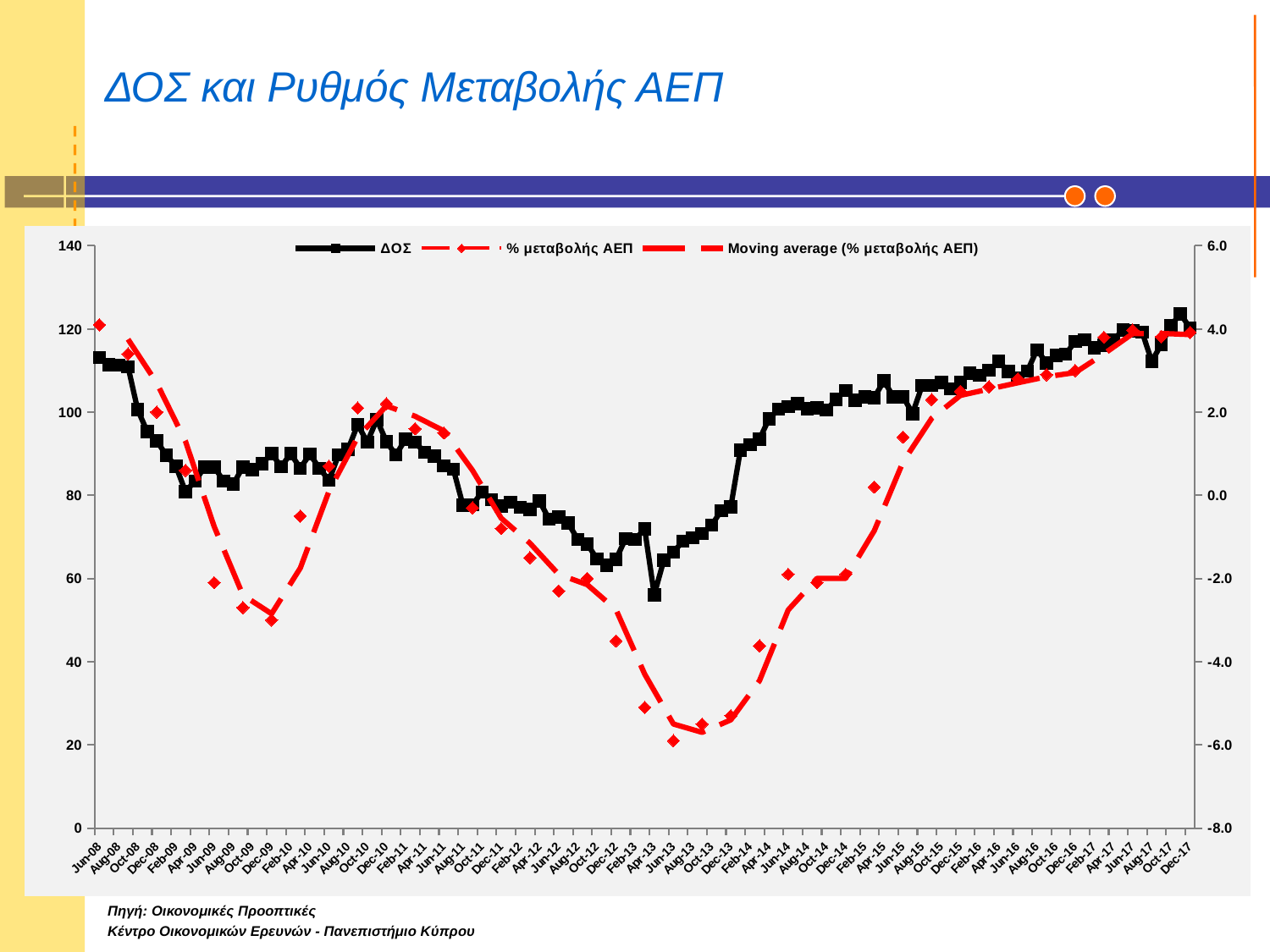
Is the value of ΔΟΣ at Apr-13 greater or less than 60? less Is the value of % μεταβολής ΑΕΠ at Jun-13 greater or less than -4.0? less Is the value of ΔΟΣ at Jun-08 greater or less than 100? greater Which is larger, the ΔΟΣ value at Jun-08 or at Apr-13? Jun-08 What is the title of the slide's chart? ΔΟΣ και Ρυθμός Μεταβολής ΑΕΠ Does the ΔΟΣ series rise or fall between Apr-13 and Dec-17? rise How many series does the legend list? 3 What kind of chart is shown on the slide? line chart Which series is drawn as a black line with square markers? ΔΟΣ Does the ΔΟΣ series rise or fall between Jun-08 and Apr-09? fall